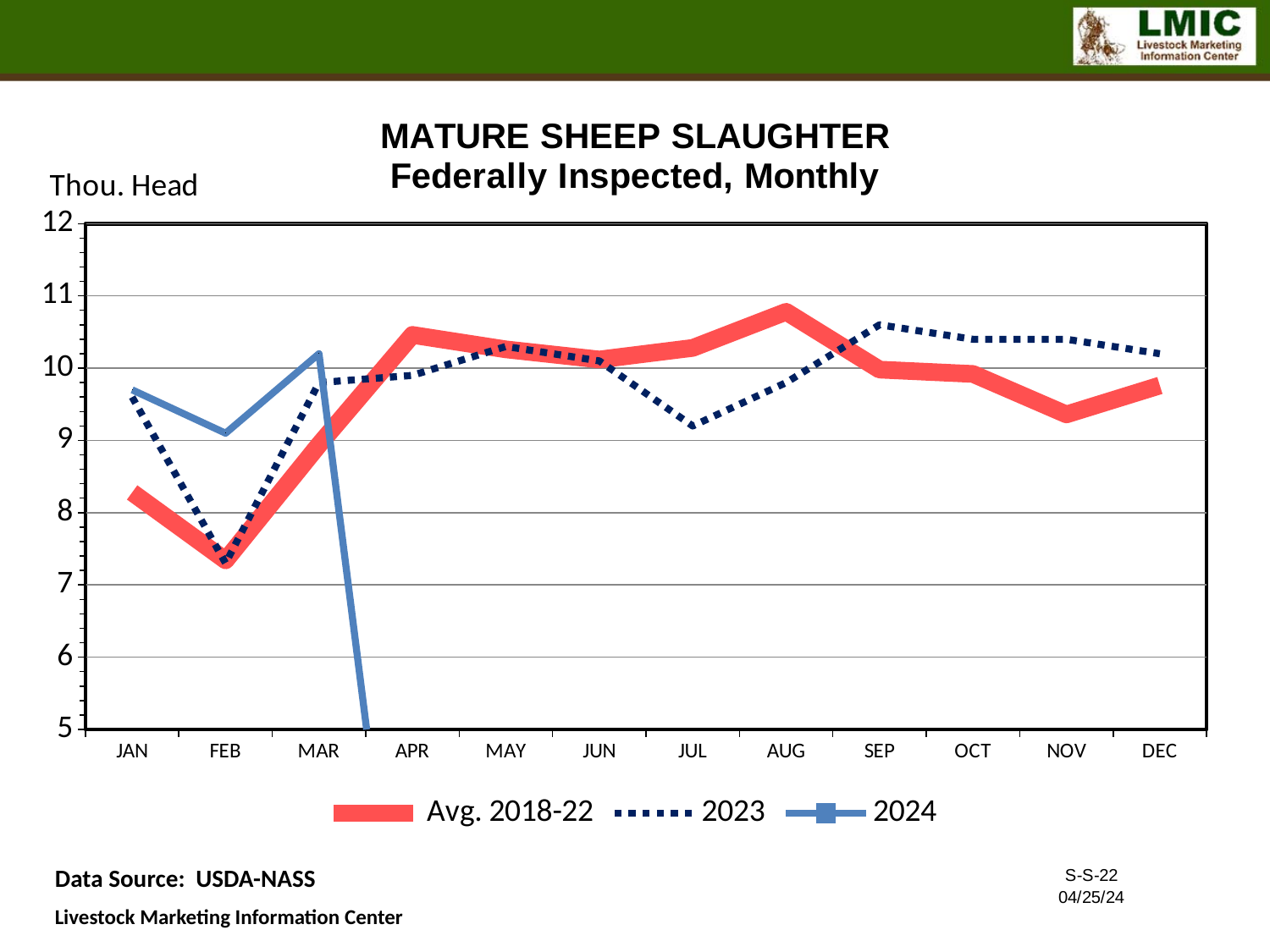
What is the title of the chart? MATURE SHEEP SLAUGHTER Federally Inspected, Monthly Is the Avg. 2018-22 value for FEB greater or less than 8? less How many series does the legend list? 3 Does the Avg. 2018-22 series rise or fall from FEB to APR? rise How many months are shown along the x axis? 12 What kind of chart is shown on the slide? line chart In which month is the Avg. 2018-22 series lowest? FEB Is the 2024 value for JAN greater or less than 9? greater Is the 2023 value for JUL greater or less than 10? less In FEB, which is higher: the 2024 value or the Avg. 2018-22 value? 2024 What unit is shown on the y axis label? Thou. Head In which month is the 2023 series lowest? FEB